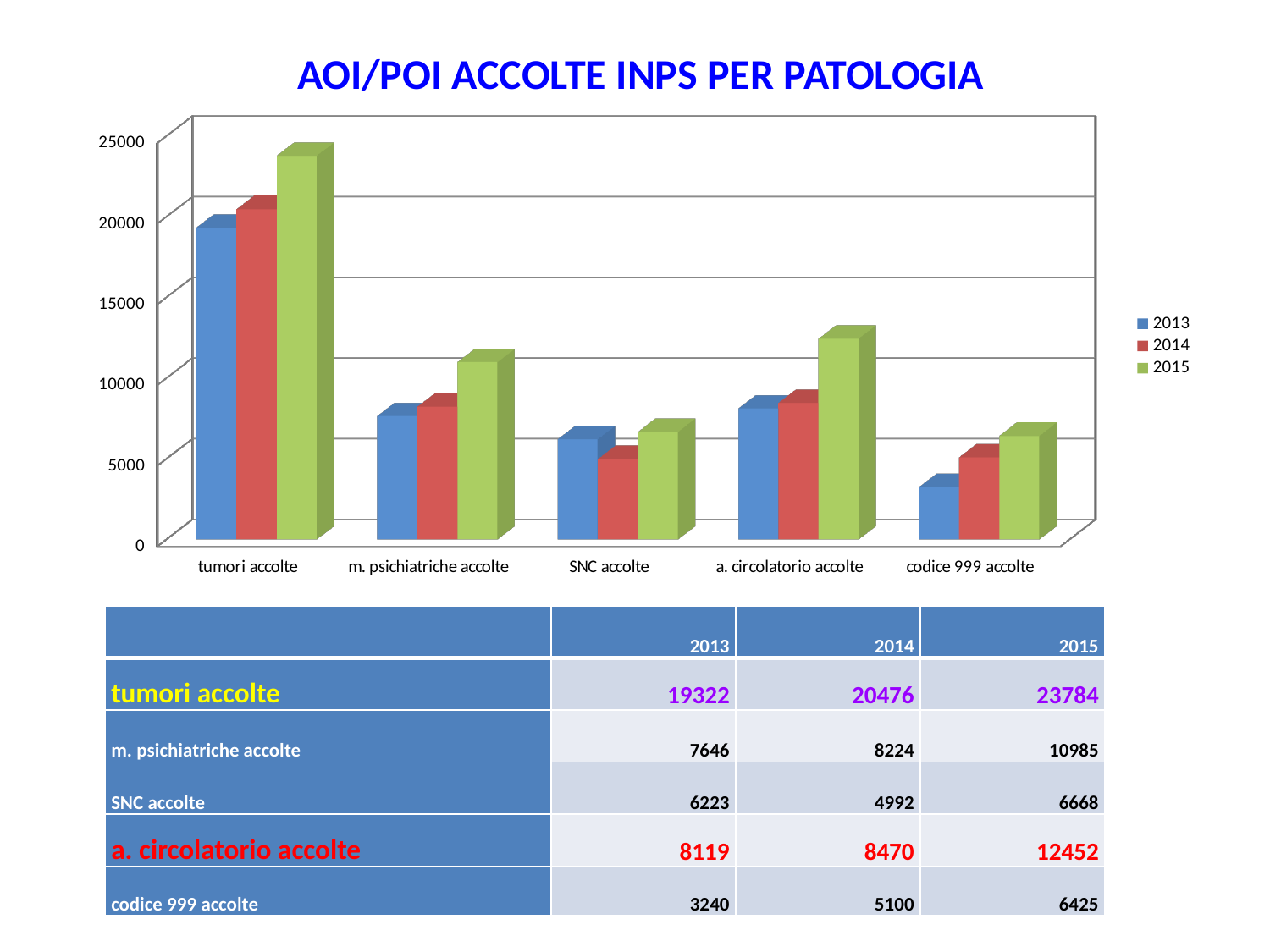
What is the value for tumori accolte in 2015? 23784 Do the values for codice 999 accolte rise or fall from 2013 to 2015? rise Which category has the highest value for 2013? tumori accolte What is the value for SNC accolte in 2014? 4992 Which category has the lowest value for 2015? codice 999 accolte What is the difference between the 2015 and 2013 values for a. circolatorio accolte? 4333 How many categories are shown on the x axis? 5 What is the title of the chart? AOI/POI ACCOLTE INPS PER PATOLOGIA What kind of chart is shown on the slide? bar chart Which is larger in 2014: m. psichiatriche accolte or a. circolatorio accolte? a. circolatorio accolte Is the value for tumori accolte in 2013 greater or less than 15000? greater How many series does the legend list? 3